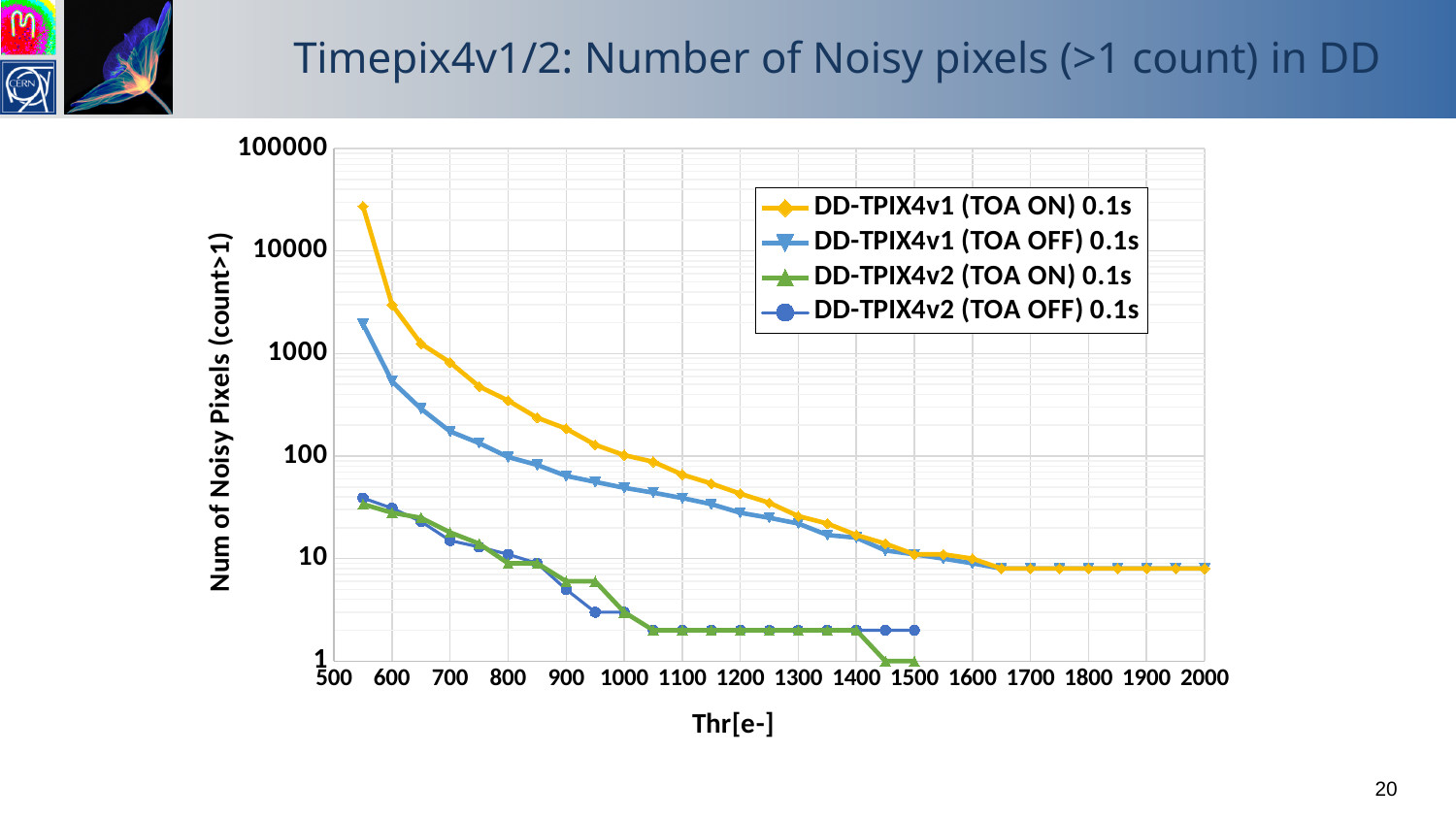
Which series has the highest number of noisy pixels at a threshold of 550 e-? DD-TPIX4v1 (TOA ON) 0.1s What kind of chart is shown on the slide? line chart What is the title of the y axis? Num of Noisy Pixels (count>1) Is the value for DD-TPIX4v1 (TOA ON) 0.1s at a threshold of 800 e- greater or less than 100? greater At a threshold of 600 e-, which series has the larger value: DD-TPIX4v1 (TOA ON) 0.1s or DD-TPIX4v2 (TOA ON) 0.1s? DD-TPIX4v1 (TOA ON) 0.1s What is the title of the x axis? Thr[e-] Is the value for DD-TPIX4v1 (TOA ON) 0.1s at a threshold of 550 e- greater or less than 10000? greater Is the value for DD-TPIX4v1 (TOA ON) 0.1s at a threshold of 2000 e- greater or less than 10? less How many series does the legend list? 4 Do the number of noisy pixels rise or fall as the threshold increases along the x axis? fall